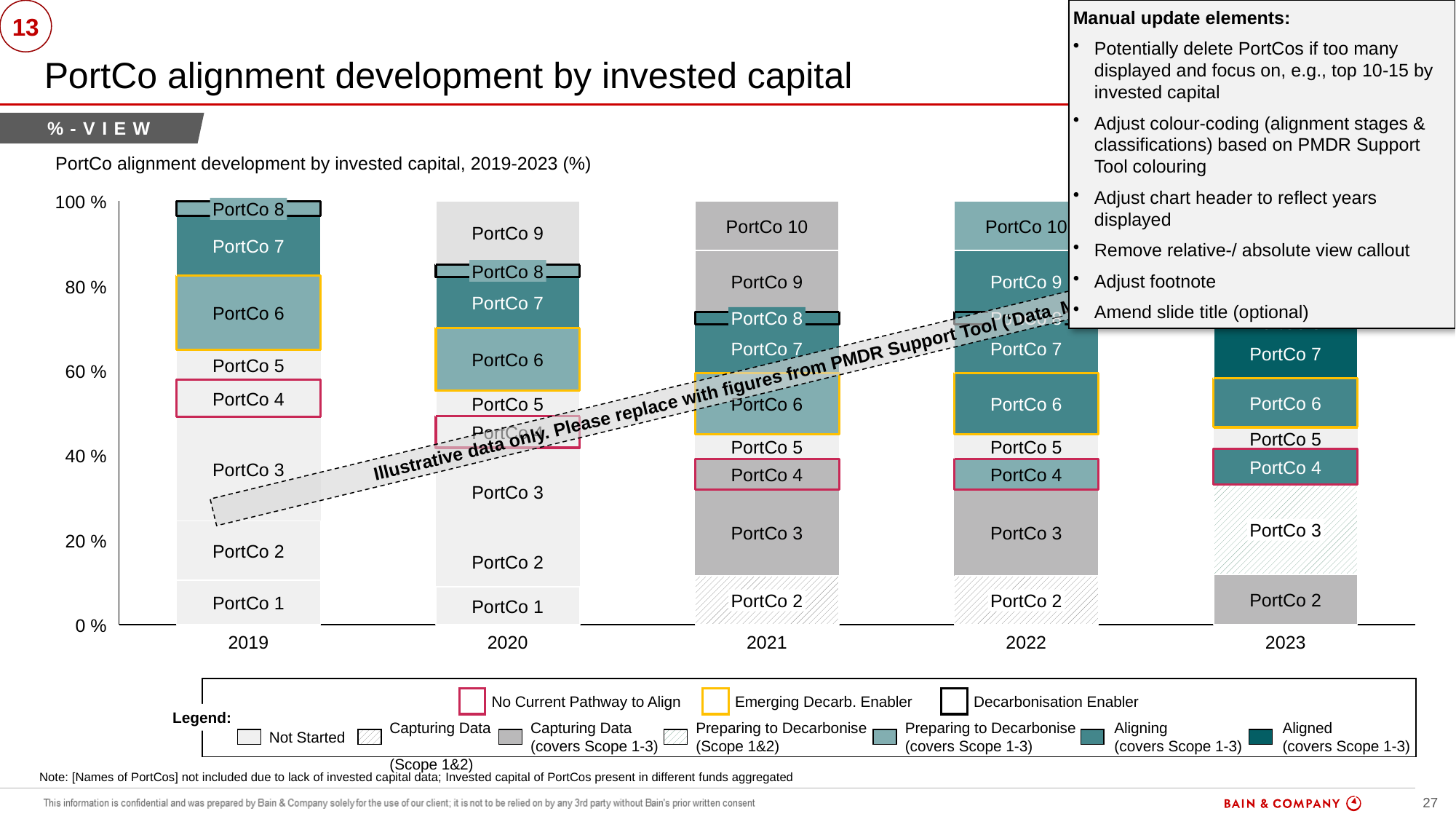
What kind of chart is shown on the slide? Stacked bar chart Which PortCo is the top segment of the 2021 bar? PortCo 10 What is the total height of each stacked bar in the chart? 100 % Which PortCo is the bottom segment of the 2023 bar? PortCo 2 How many PortCo segments make up the 2021 bar? 9 According to the legend, what does the pink outline around a segment indicate? No Current Pathway to Align Which PortCo is the bottom segment of the 2019 bar? PortCo 1 How many years are shown along the x axis of the chart? 5 How many PortCo segments make up the 2019 bar? 8 What is the title of the chart? PortCo alignment development by invested capital, 2019-2023 (%) In 2019, which segment is larger, PortCo 3 or PortCo 1? PortCo 3 In 2019, is the share for PortCo 1 greater or less than 20%? less